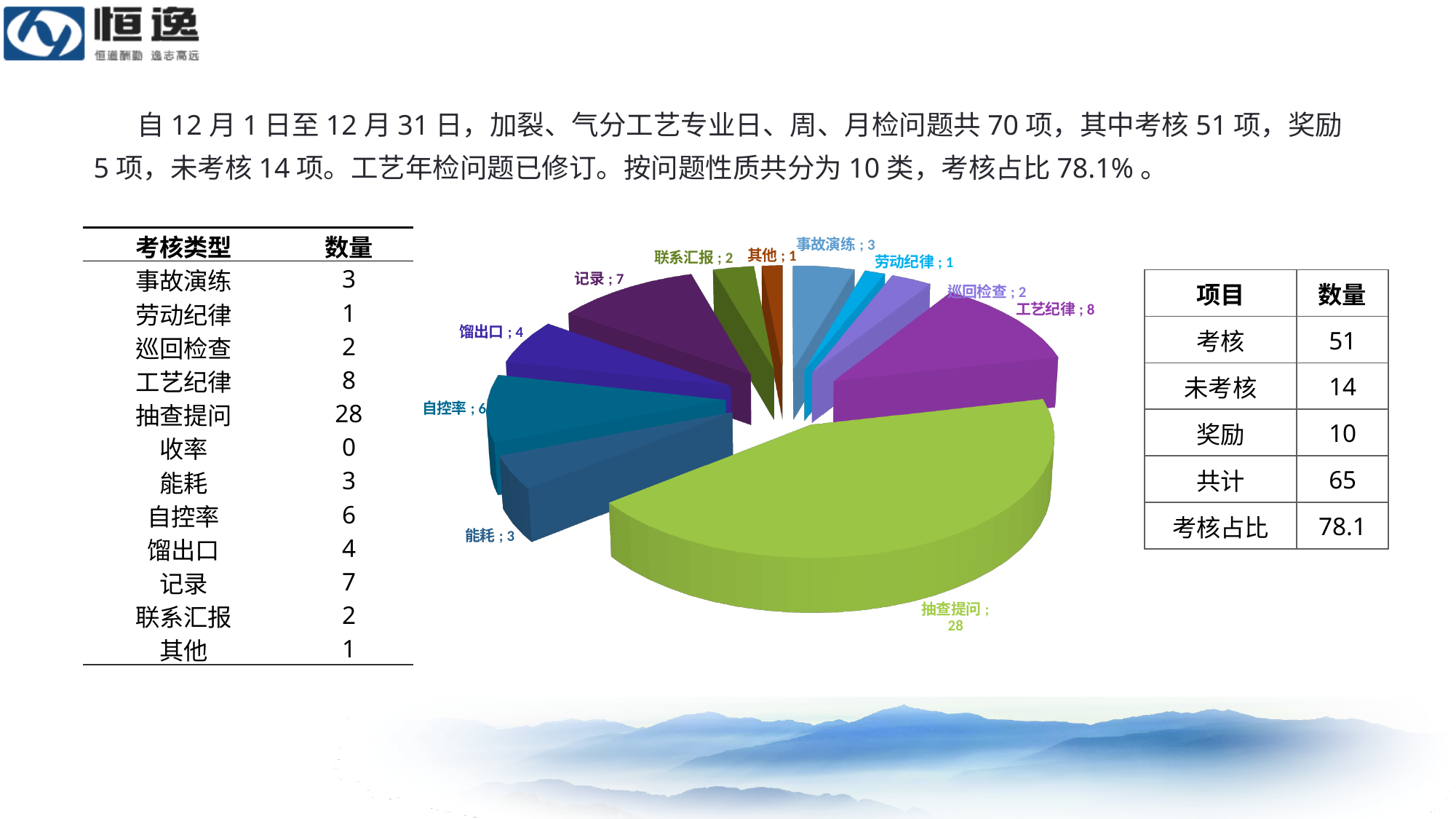
In the pie chart, which is larger: 工艺纪律 or 记录? 工艺纪律 In the pie chart, what is the value for 联系汇报? 2 In the pie chart, what is the value for 工艺纪律? 8 What is the difference between the values for 记录 and 馏出口 in the pie chart? 3 Which category has the largest slice in the pie chart? 抽查提问 In the pie chart, what is the value for 抽查提问? 28 What is the difference between the values for 抽查提问 and 工艺纪律 in the pie chart? 20 How many labelled slices does the pie chart have? 11 What type of chart is shown on the slide? pie chart In the pie chart, what is the value for 自控率? 6 In the pie chart, which is larger: 自控率 or 能耗? 自控率 In the pie chart, what is the value for 记录? 7